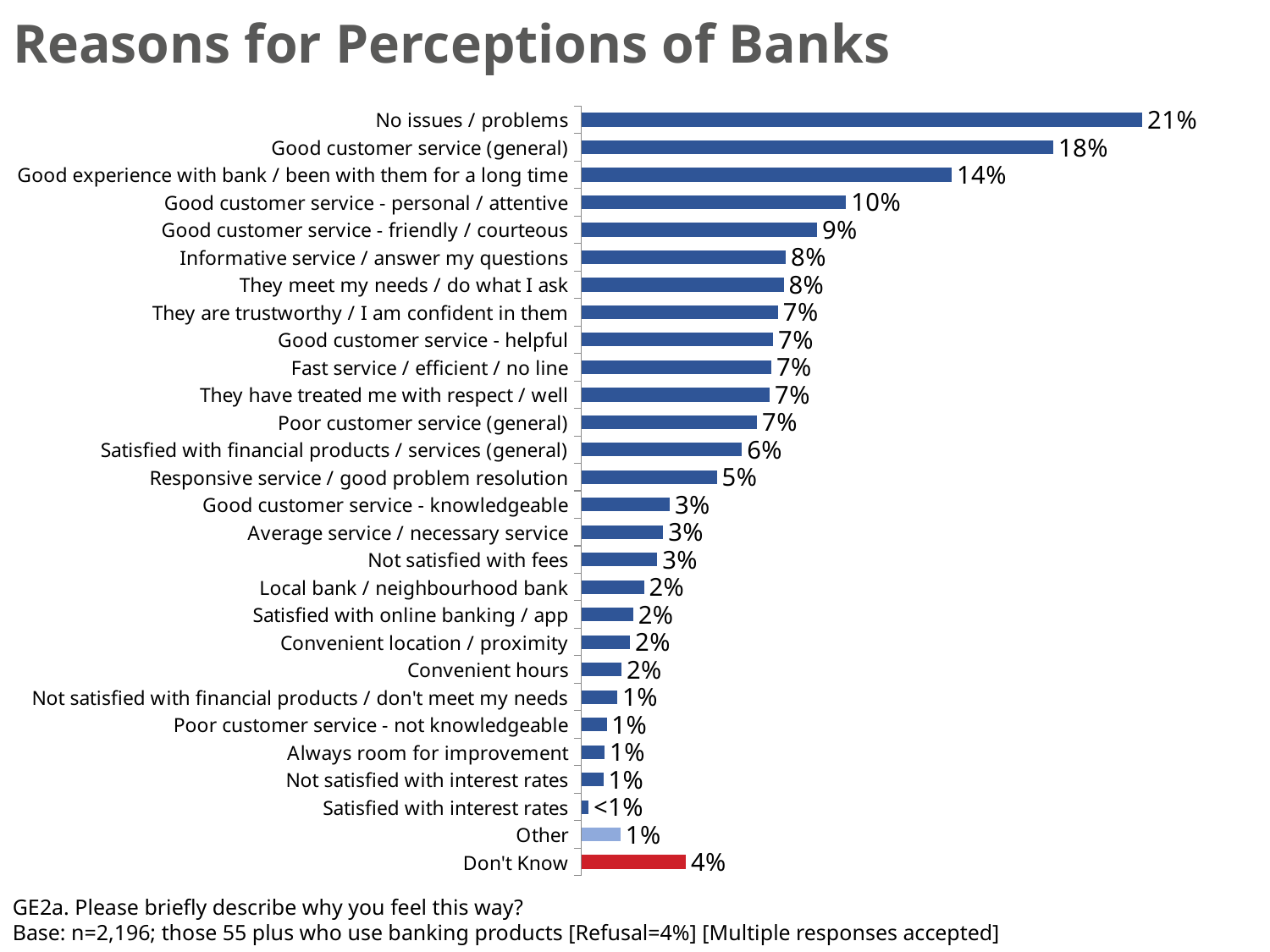
What is the difference between "No issues / problems" and "Good customer service (general)"? 3 percentage points How many reasons (bars) are shown in the chart? 28 What is the value shown for "Satisfied with interest rates"? <1% Which reason has the highest percentage? No issues / problems What is the difference between "Good experience with bank / been with them for a long time" and "Good customer service - personal / attentive"? 4 percentage points What is the value for "Good customer service (general)"? 18% What type of chart is shown on the slide? Bar chart Which is larger: "Poor customer service (general)" or "Responsive service / good problem resolution"? Poor customer service (general) Which reason has the lowest percentage? Satisfied with interest rates Which bar is coloured red? Don't Know What percentage of respondents gave "No issues / problems" as a reason? 21% What percentage is shown for "Don't Know"? 4%